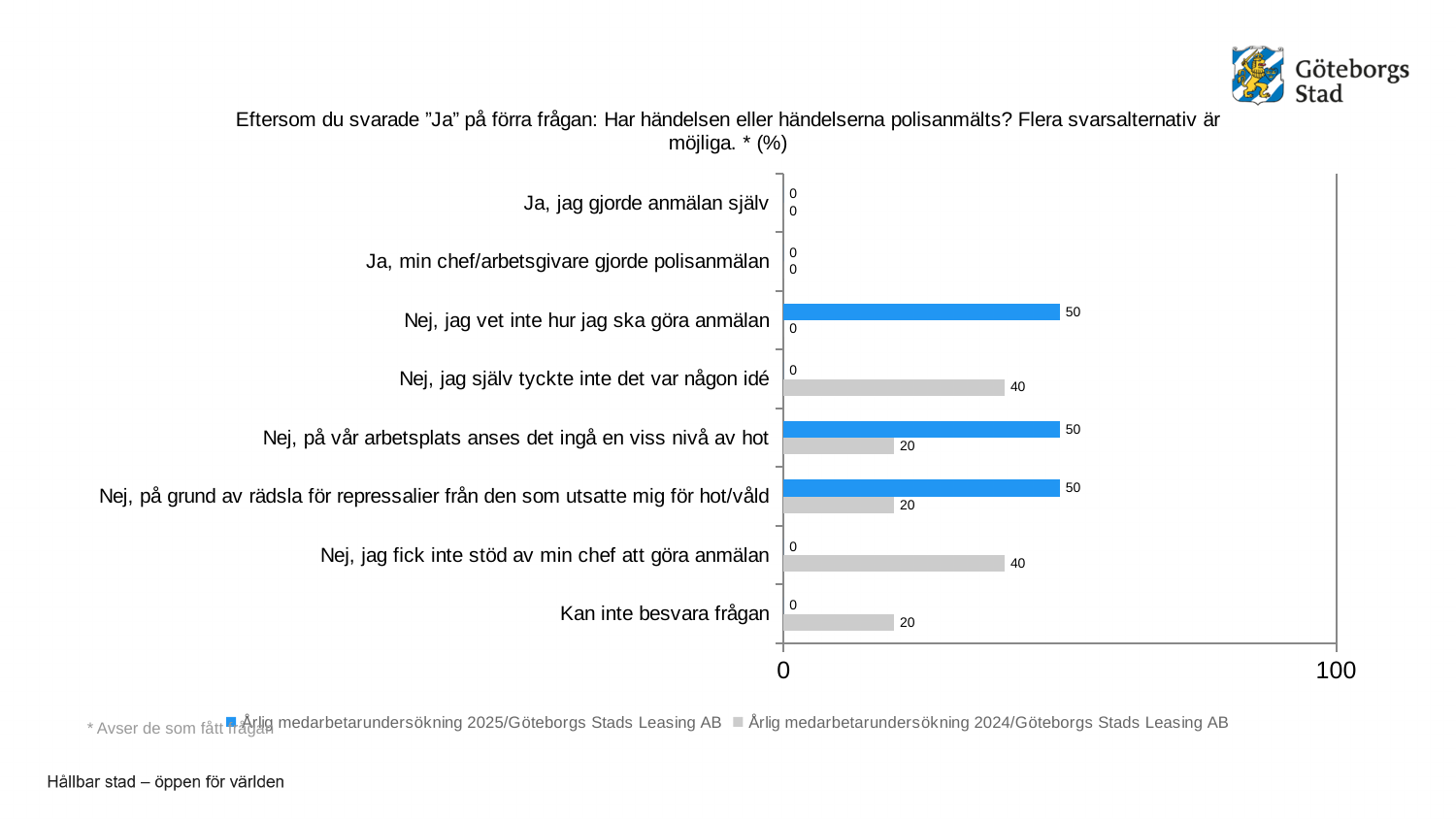
What is the value for "Kan inte besvara frågan" in the Årlig medarbetarundersökning 2024 series? 20 For "Nej, på grund av rädsla för repressalier från den som utsatte mig för hot/våld", which series has the larger value, 2025 or 2024? 2025 What is the difference between the 2024 and 2025 values for "Nej, jag fick inte stöd av min chef att göra anmälan"? 40 How many categories are shown on the chart? 8 What is the difference between the 2025 and 2024 values for "Nej, på vår arbetsplats anses det ingå en viss nivå av hot"? 30 How many series does the legend list? 2 What is the maximum value shown on the x axis? 100 Which series is shown in blue? Årlig medarbetarundersökning 2025/Göteborgs Stads Leasing AB What kind of chart is shown on the slide? bar chart What is the value for "Nej, jag vet inte hur jag ska göra anmälan" in the Årlig medarbetarundersökning 2025 series? 50 What is the value for "Ja, jag gjorde anmälan själv" in the Årlig medarbetarundersökning 2025 series? 0 What is the value for "Nej, jag själv tyckte inte det var någon idé" in the Årlig medarbetarundersökning 2024 series? 40